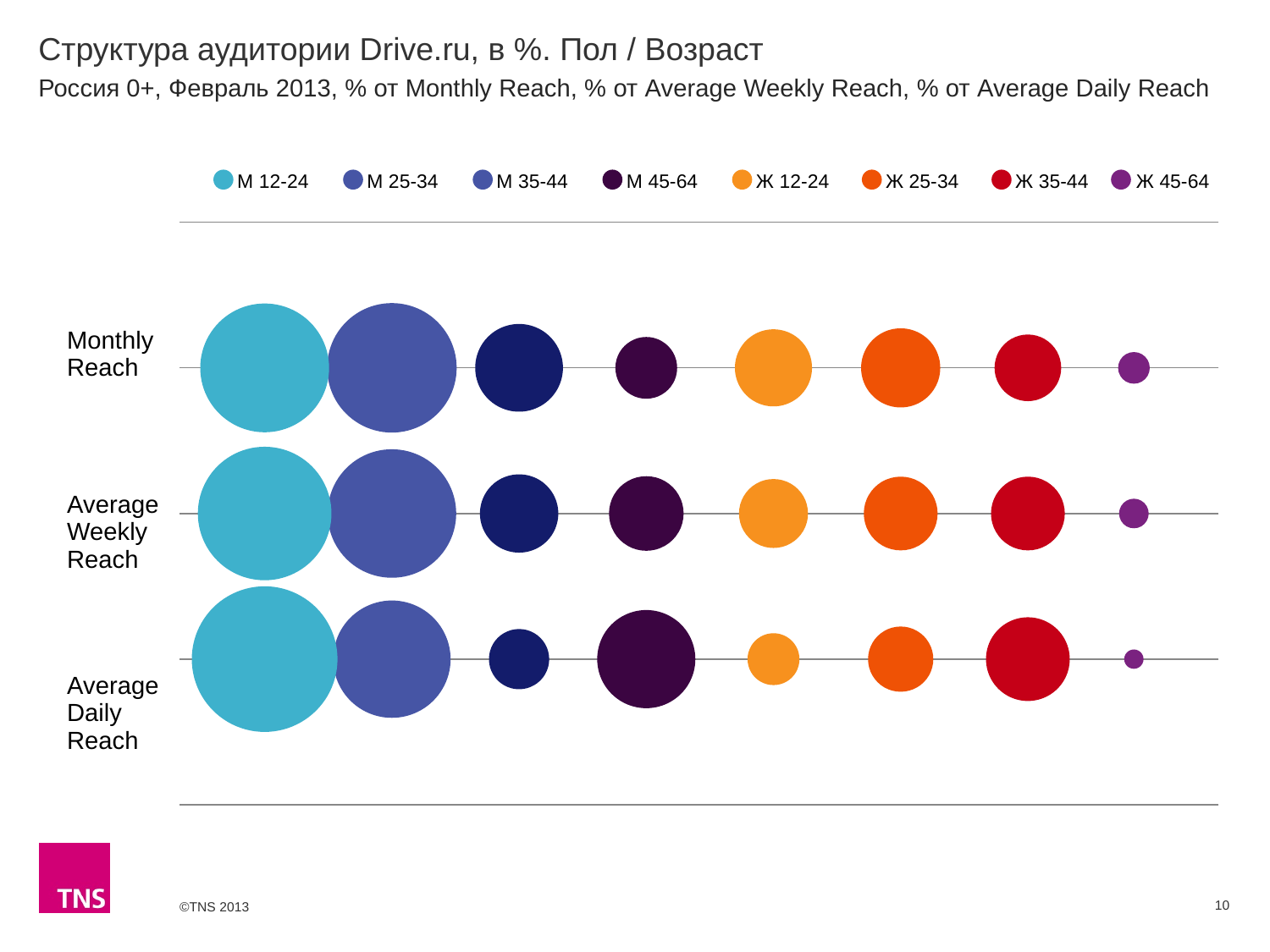
How many series does the legend list? 8 How many reach categories (rows) are plotted on the chart? 3 What is the title of the chart on the slide? Структура аудитории Drive.ru, в %. Пол / Возраст Which audience group has the largest bubble in the Average Daily Reach row? М 12-24 What is the first entry in the chart legend? М 12-24 For М 45-64, which row has the larger bubble: Monthly Reach or Average Daily Reach? Average Daily Reach In the Average Daily Reach row, which bubble is larger: Ж 35-44 or Ж 12-24? Ж 35-44 Which audience group has the smallest bubble in the Average Daily Reach row? Ж 45-64 Does the bubble for М 45-64 grow or shrink going from Monthly Reach to Average Daily Reach? Grow Which audience group has the smallest bubble in the Monthly Reach row? Ж 45-64 For М 35-44, which row has the larger bubble: Monthly Reach or Average Daily Reach? Monthly Reach What kind of chart is shown on the slide? Bubble chart